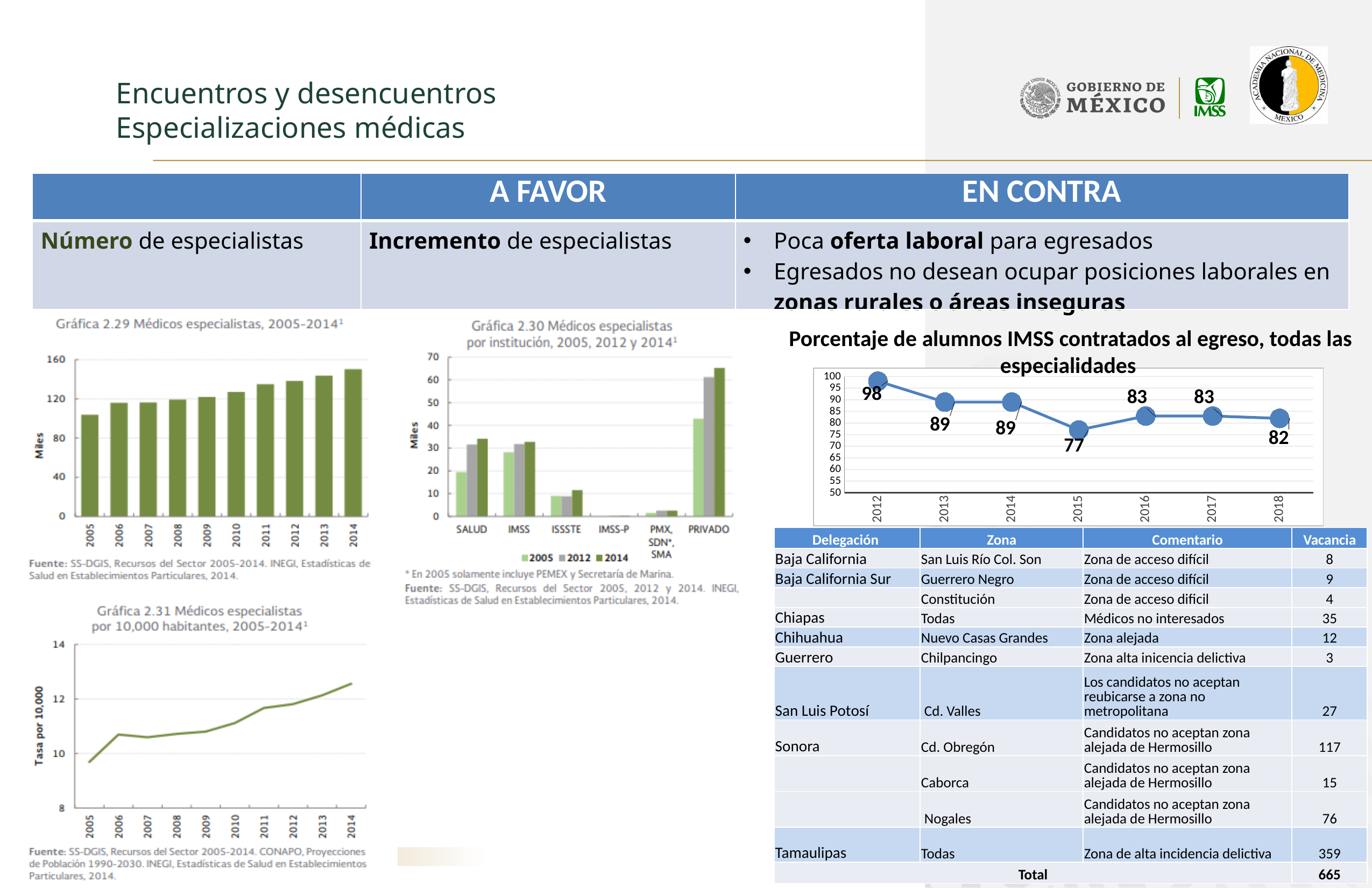
In the chart 'Porcentaje de alumnos IMSS contratados al egreso, todas las especialidades', which year has the lowest value? 2015 In the chart 'Porcentaje de alumnos IMSS contratados al egreso, todas las especialidades', what is the value for 2015? 77 How many series does the legend of 'Gráfica 2.30 Médicos especialistas por institución' list? 3 What kind of chart is 'Gráfica 2.29 Médicos especialistas, 2005-2014'? bar chart In 'Gráfica 2.30 Médicos especialistas por institución', which institution has the highest value for 2014? PRIVADO In the chart 'Porcentaje de alumnos IMSS contratados al egreso, todas las especialidades', how many years are plotted? 7 In the chart 'Porcentaje de alumnos IMSS contratados al egreso, todas las especialidades', what is the difference between the 2012 value and the 2018 value? 16 In 'Gráfica 2.29 Médicos especialistas, 2005-2014', is the value for 2005 greater or less than 120? less In 'Gráfica 2.29 Médicos especialistas, 2005-2014', do the values rise or fall from 2005 to 2014? rise In the chart 'Porcentaje de alumnos IMSS contratados al egreso, todas las especialidades', what is the value for 2012? 98 In the chart 'Porcentaje de alumnos IMSS contratados al egreso, todas las especialidades', which year has the highest value? 2012 In the chart 'Porcentaje de alumnos IMSS contratados al egreso, todas las especialidades', is the value for 2013 larger or smaller than the value for 2016? larger